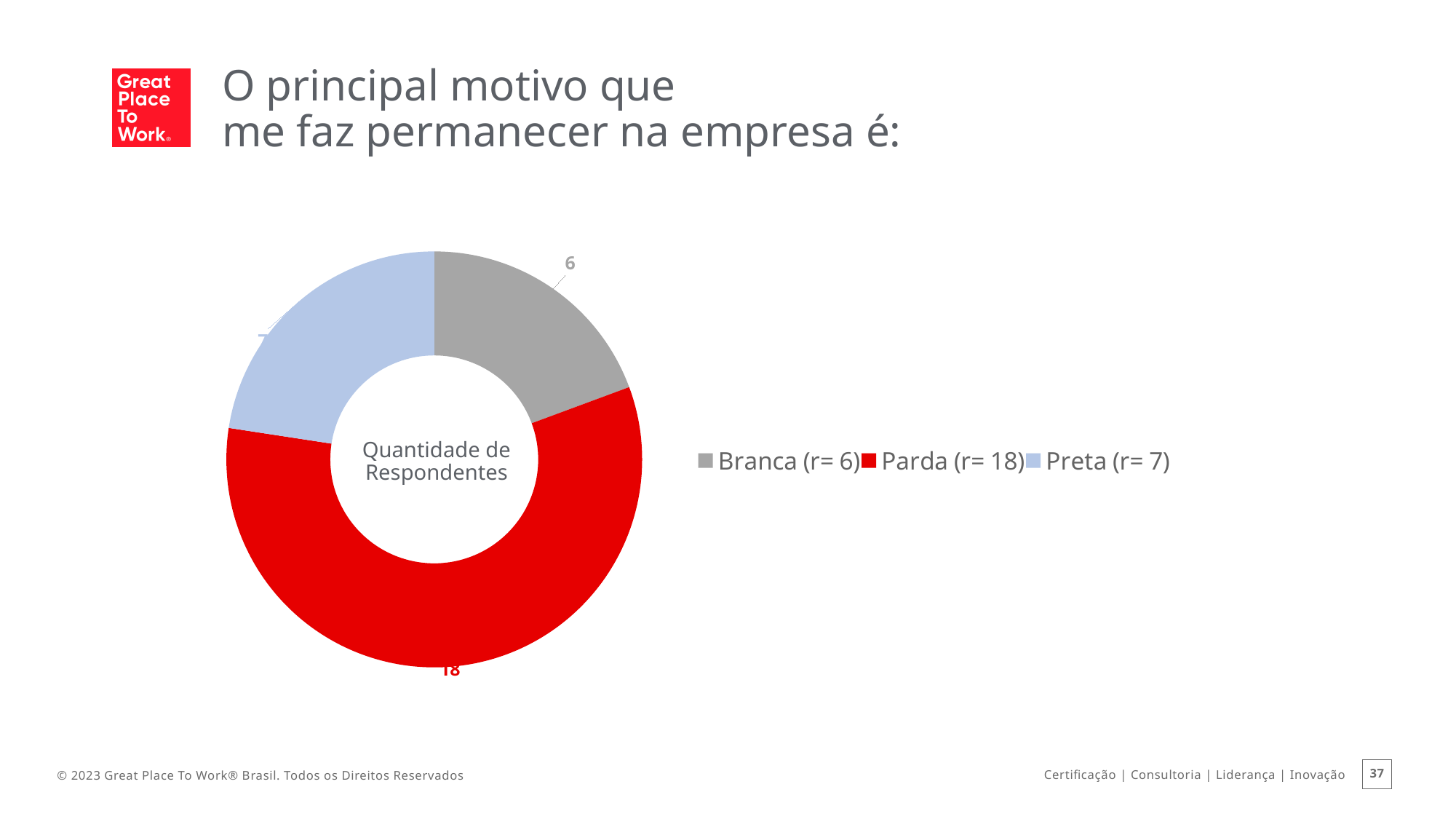
How many entries does the legend list? 3 Which category has the highest value? Parda What kind of chart is shown on the slide? Doughnut chart What text is shown in the centre of the doughnut chart? Quantidade de Respondentes How many categories does the doughnut chart show? 3 Which is larger, the value for Parda or the value for Branca? Parda What is the value for Preta? 7 What is the difference between the values for Parda and Preta? 11 What is the total of all the values in the doughnut chart? 31 Which category has the lowest value? Branca What is the value for Parda? 18 What is the value for Branca? 6